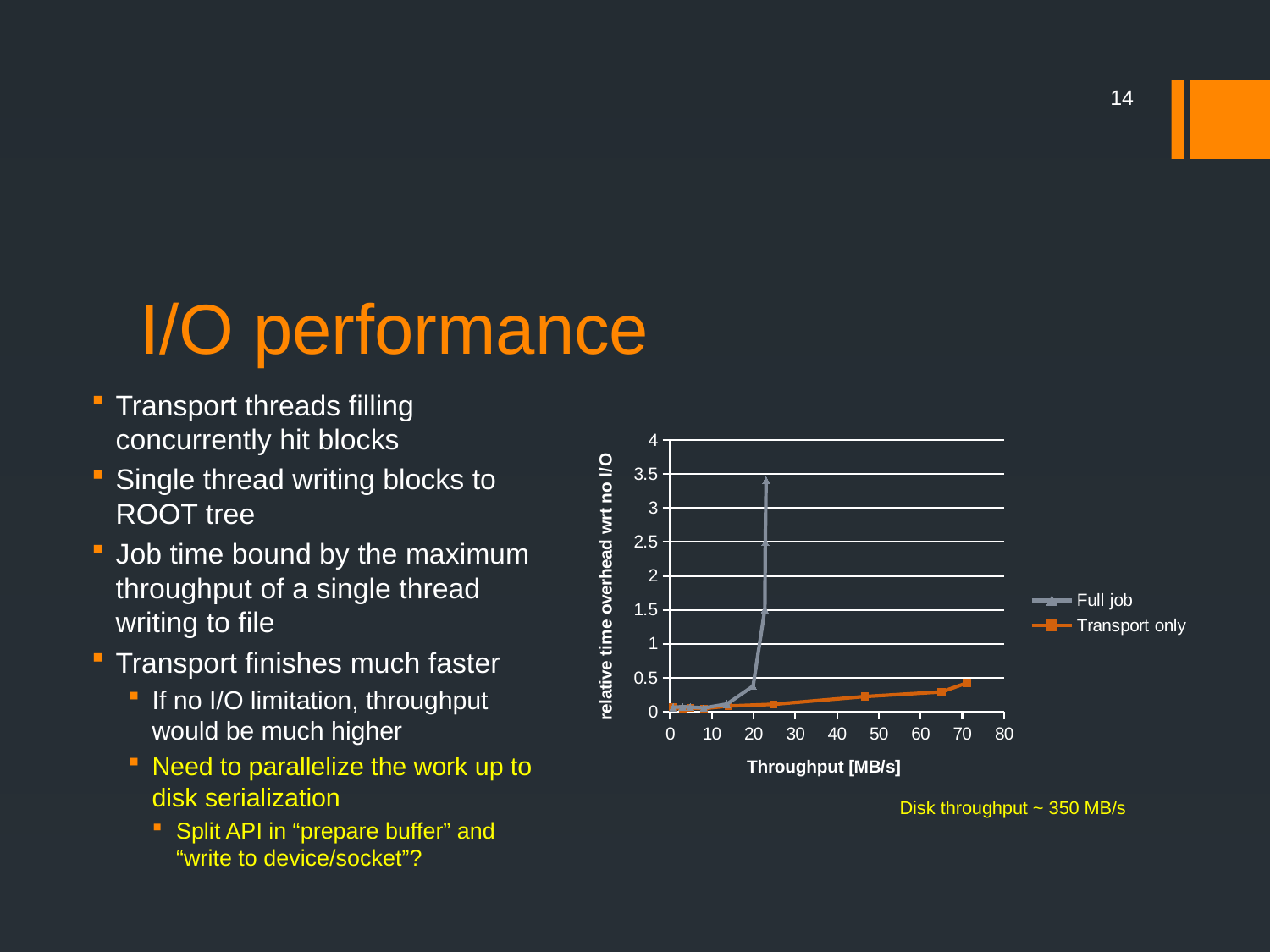
Does the relative time overhead for the Transport only series rise or fall as throughput increases? rise What kind of chart is shown on the slide? line chart What are the two series named in the chart legend? Full job, Transport only Does the relative time overhead for the Full job series rise or fall as throughput increases? rise Is the highest value reached by the Transport only series greater or less than 0.5? less How many series does the chart legend list? 2 Which series reaches the higher relative time overhead, Full job or Transport only? Full job Is the highest value reached by the Transport only series greater or less than 1? less Which series extends to the higher throughput on the x axis, Full job or Transport only? Transport only Is the highest value reached by the Full job series greater or less than 3? greater What is the title of the x axis of the chart? Throughput [MB/s]